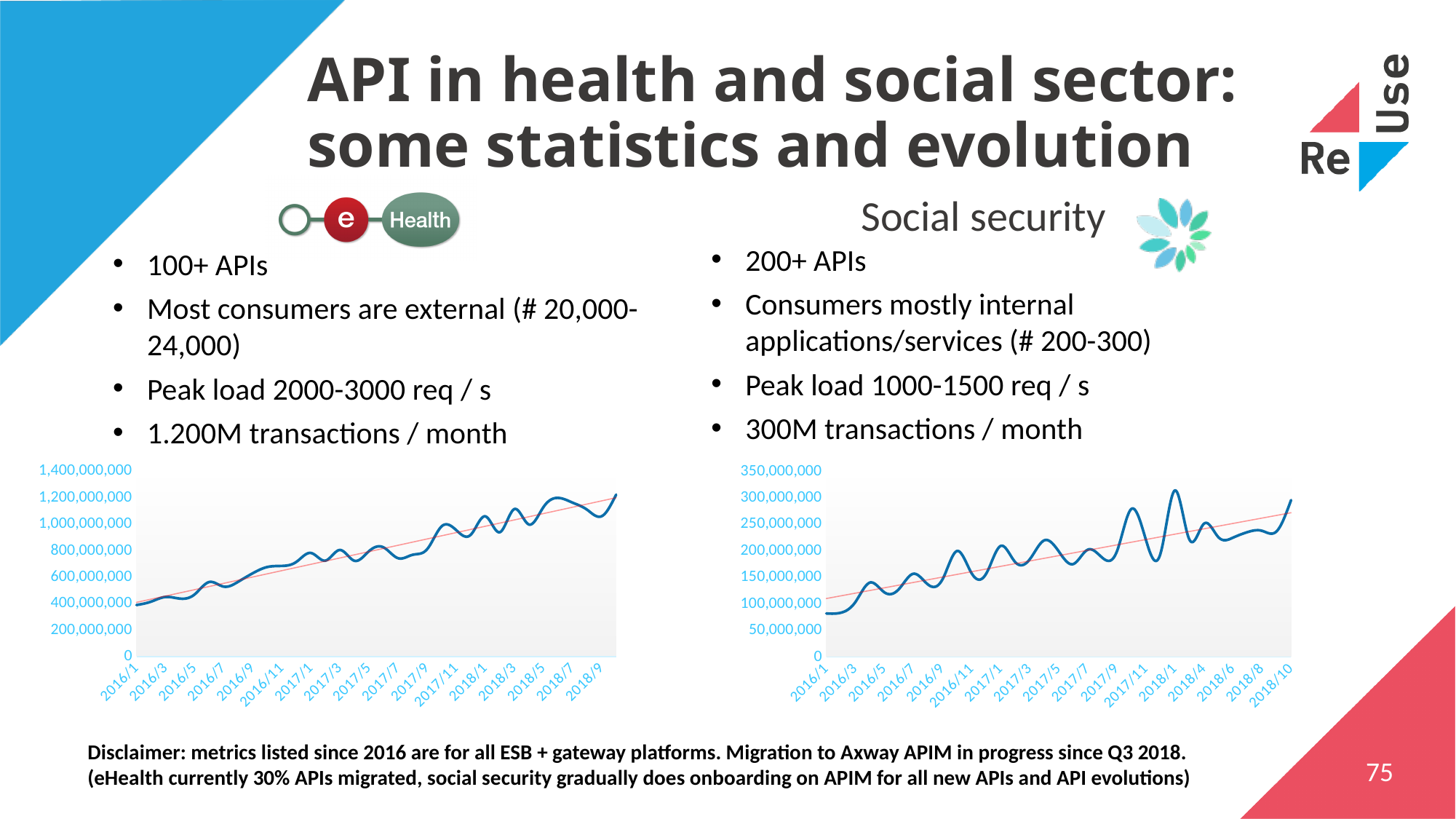
What is the highest value shown on the y axis of the right (Social security) chart? 350,000,000 In the right (Social security) chart, which x-axis label has the lowest value? 2016/1 In the right (Social security) chart, do the values generally rise or fall from 2016/1 to 2018/10? rise In the left (eHealth) chart, is the value at 2017/1 greater or less than 600,000,000? greater In the right (Social security) chart, is the value at 2018/10 greater or less than 250,000,000? greater What kind of chart is the right chart under the Social security bullets? line chart What is the highest value shown on the y axis of the left (eHealth) chart? 1,400,000,000 In the left (eHealth) chart, do the values generally rise or fall from 2016/1 to 2018/9? rise In the right (Social security) chart, is the value at 2016/1 greater or less than 100,000,000? less What kind of chart is the left chart under the eHealth bullets? line chart